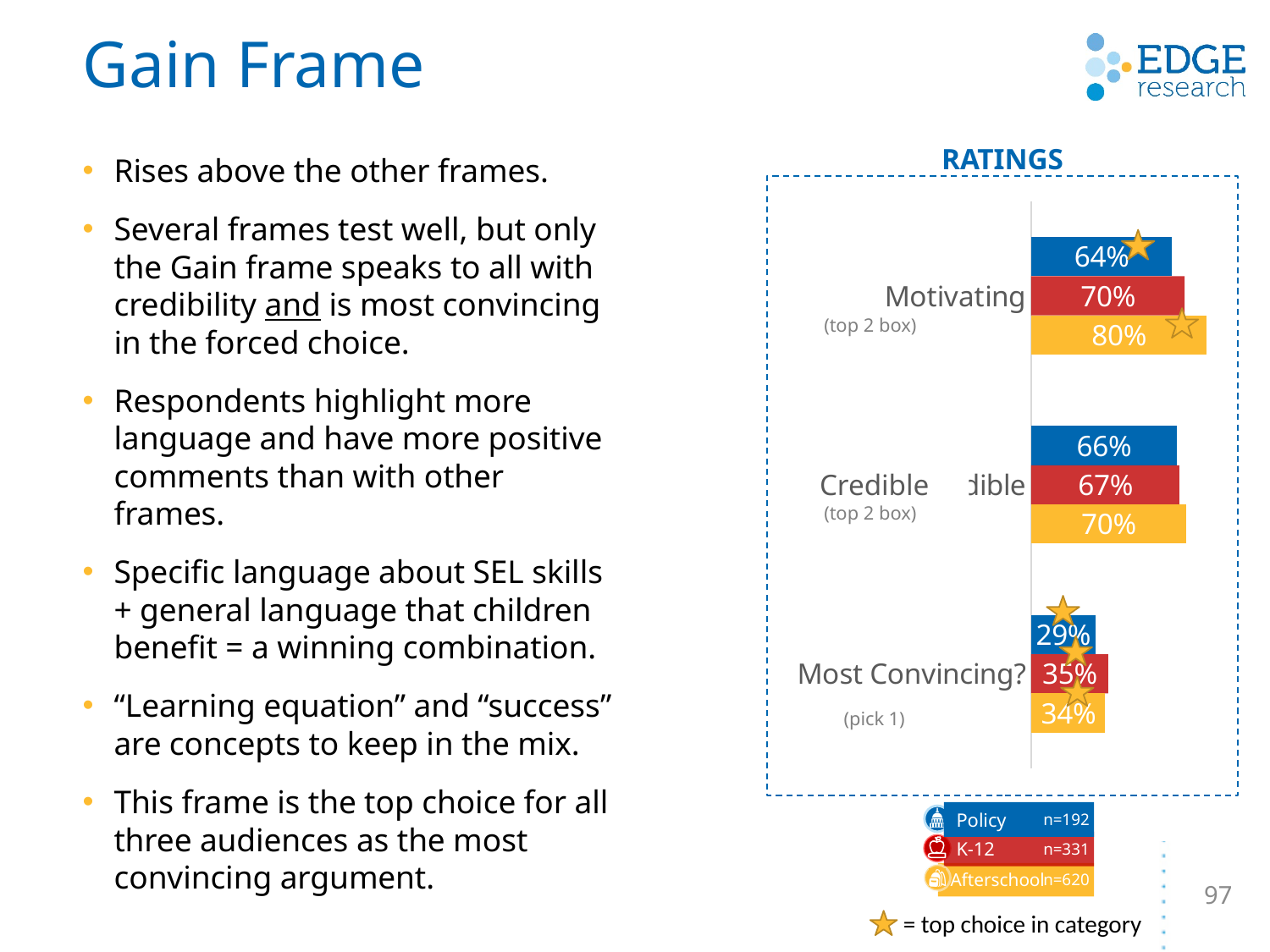
Which audience has the highest Motivating (top 2 box) rating? Afterschool Which is larger: the Afterschool value for Credible (top 2 box) or the Policy value for Credible (top 2 box)? Afterschool What kind of chart is the RATINGS chart? Bar chart How many series does the legend list? 3 What is the K-12 value for Motivating (top 2 box)? 70% What is the difference between the Afterschool and Policy values for Motivating (top 2 box)? 16% What is the Policy value for Credible (top 2 box)? 66% How many categories are shown in the RATINGS chart? 3 What is the Afterschool value for Motivating (top 2 box)? 80% Which audience has the lowest Most Convincing? (pick 1) value? Policy What is the difference between the K-12 and Policy values for Most Convincing? (pick 1)? 6% What is the K-12 value for Most Convincing? (pick 1)? 35%